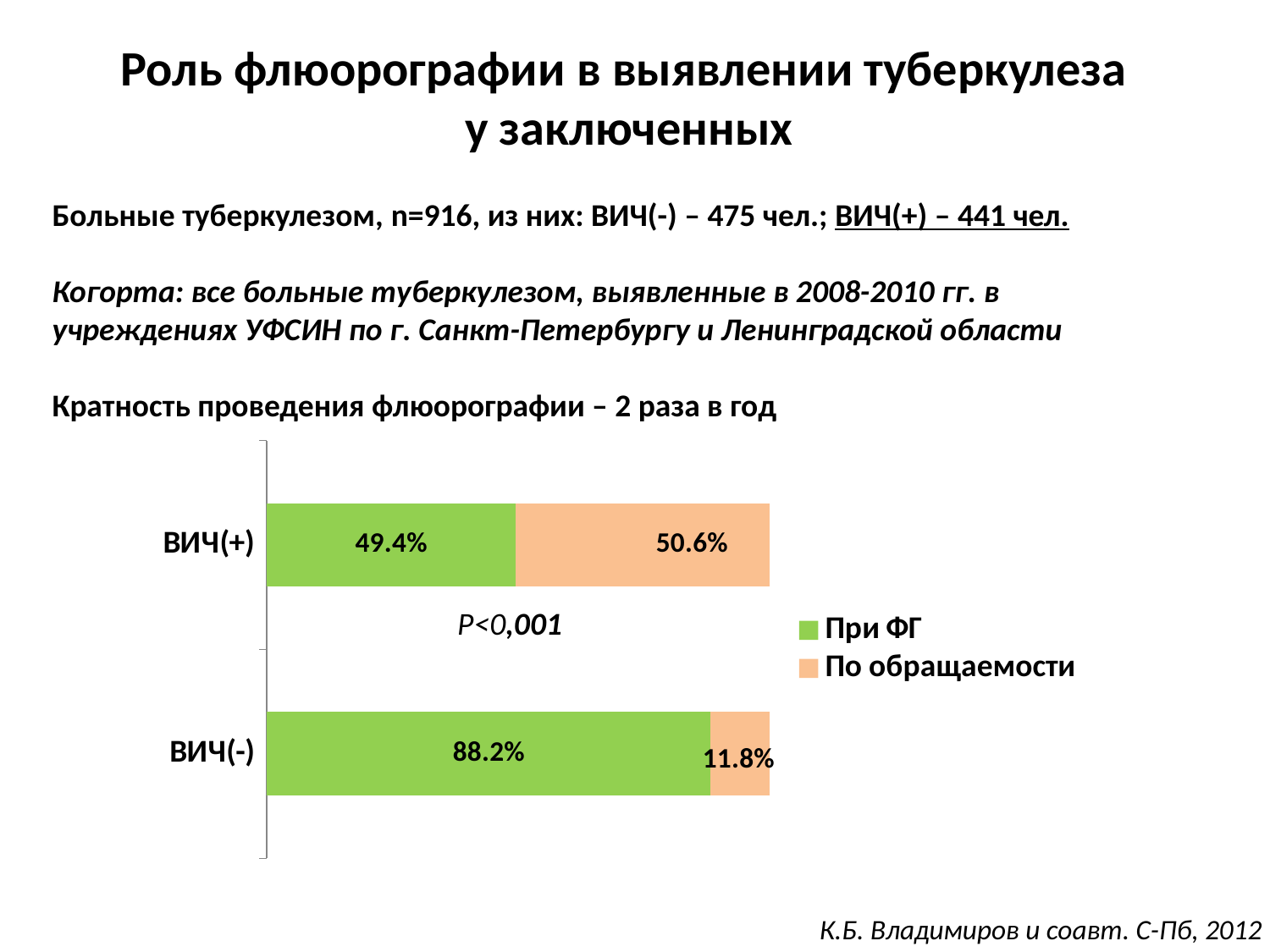
How many series does the legend list? 2 What is the value for "По обращаемости" in the ВИЧ(-) bar? 11.8% What is the total of the ВИЧ(+) stacked bar? 100% What is the value for "По обращаемости" in the ВИЧ(+) bar? 50.6% What is the value for "При ФГ" in the ВИЧ(+) bar? 49.4% Which category has the highest value for "При ФГ"? ВИЧ(-) Which is larger: "По обращаемости" for ВИЧ(+) or for ВИЧ(-)? ВИЧ(+) Which category has the lowest value for "По обращаемости"? ВИЧ(-) What is the value for "При ФГ" in the ВИЧ(-) bar? 88.2% What kind of chart is shown on the slide? Stacked bar chart How many categories are shown on the chart? 2 What is the difference between the "При ФГ" values for ВИЧ(-) and ВИЧ(+)? 38.8%